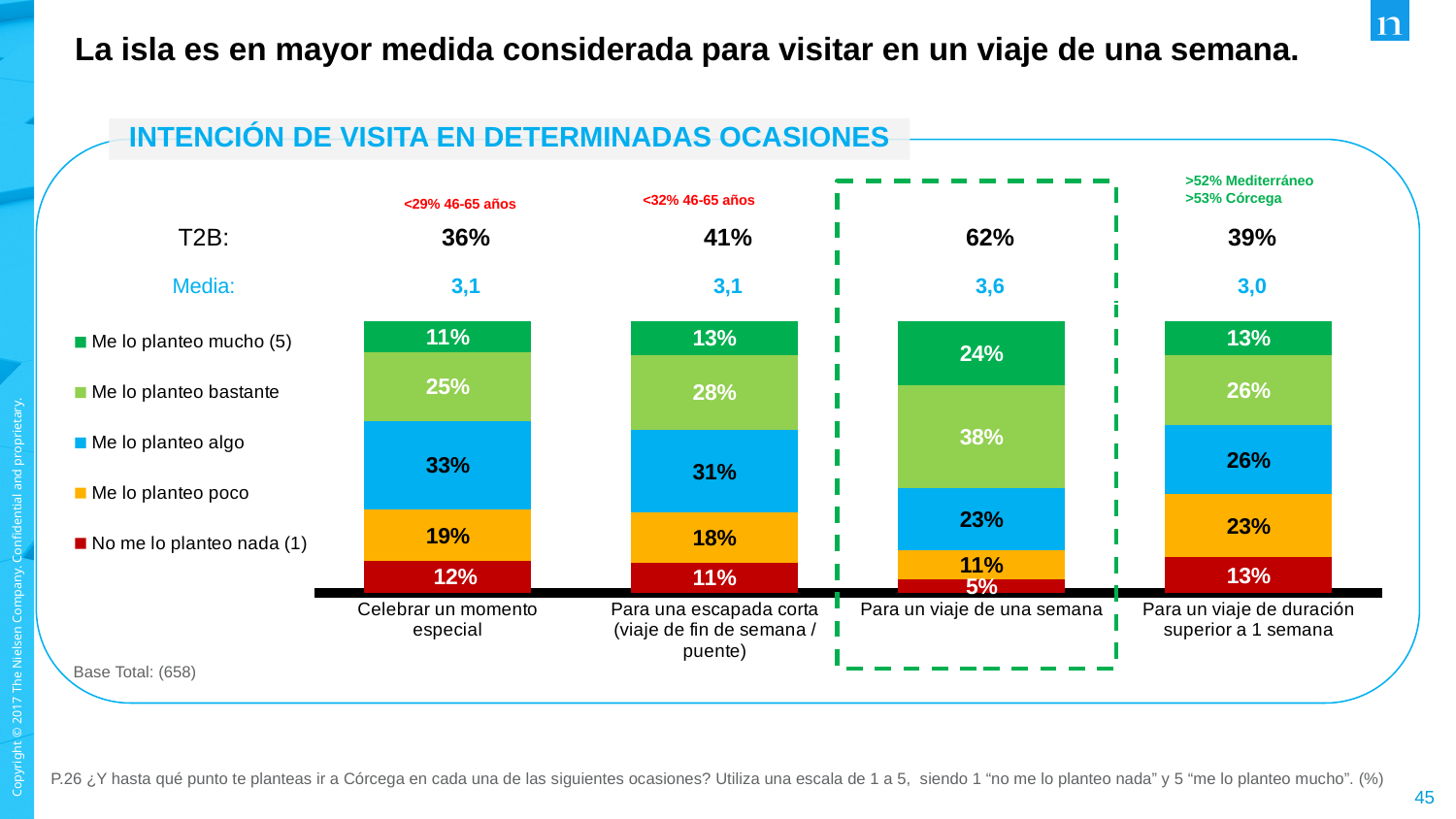
How many series does the legend list? 5 What is the T2B value shown for "Para un viaje de una semana"? 62% What is the value of "No me lo planteo nada (1)" for "Celebrar un momento especial"? 12% What is the Media value shown for "Para un viaje de duración superior a 1 semana"? 3,0 Which has a larger "Me lo planteo poco" value: "Para un viaje de una semana" or "Para un viaje de duración superior a 1 semana"? Para un viaje de duración superior a 1 semana How many occasions (categories) are shown in the chart? 4 Which occasion has the highest value for "Me lo planteo bastante"? Para un viaje de una semana What is the difference in "Me lo planteo algo" between "Celebrar un momento especial" and "Para una escapada corta"? 2 percentage points Which occasion has the lowest value for "No me lo planteo nada (1)"? Para un viaje de una semana What is the title of the chart? INTENCIÓN DE VISITA EN DETERMINADAS OCASIONES What kind of chart is shown on the slide? Stacked bar chart What percentage of respondents answered "Me lo planteo mucho (5)" for "Para un viaje de una semana"? 24%